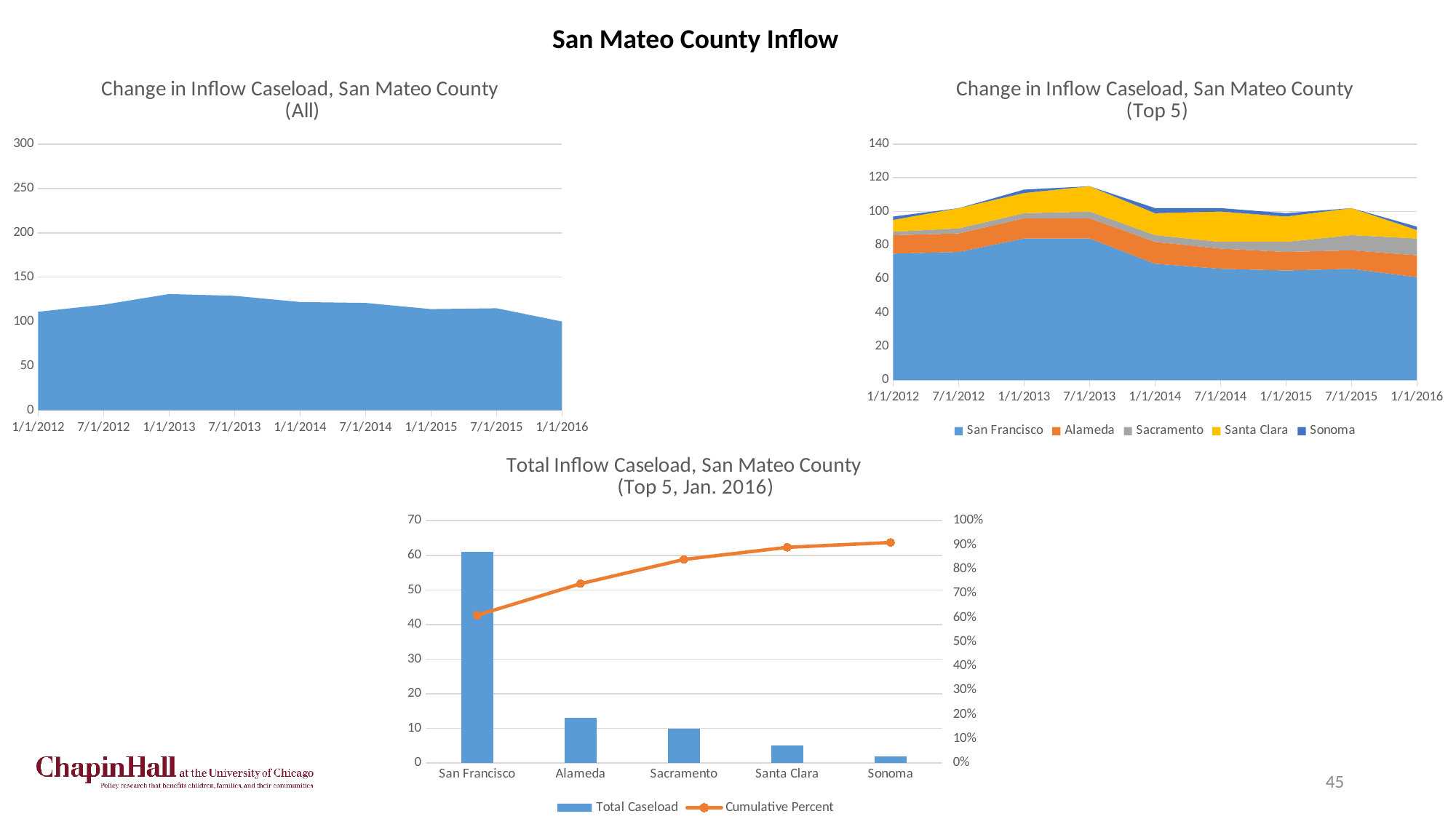
In 'Total Inflow Caseload, San Mateo County (Top 5, Jan. 2016)', which county has the highest total caseload bar? San Francisco In 'Total Inflow Caseload, San Mateo County (Top 5, Jan. 2016)', which has the larger total caseload bar, Alameda or Sacramento? Alameda How many series does the legend of 'Change in Inflow Caseload, San Mateo County (Top 5)' list? 5 In 'Total Inflow Caseload, San Mateo County (Top 5, Jan. 2016)', is the total caseload bar for San Francisco greater or less than 50? greater What are the two legend entries of 'Total Inflow Caseload, San Mateo County (Top 5, Jan. 2016)'? Total Caseload, Cumulative Percent What kind of chart is 'Change in Inflow Caseload, San Mateo County (All)'? Area chart In 'Change in Inflow Caseload, San Mateo County (All)', do the values rise or fall from 1/1/2013 to 1/1/2016? fall How many counties are shown on the x axis of 'Total Inflow Caseload, San Mateo County (Top 5, Jan. 2016)'? 5 In 'Change in Inflow Caseload, San Mateo County (Top 5)', is the top of the stacked area at 7/1/2013 greater or less than 100? greater In 'Total Inflow Caseload, San Mateo County (Top 5, Jan. 2016)', which county has the lowest total caseload bar? Sonoma In 'Total Inflow Caseload, San Mateo County (Top 5, Jan. 2016)', is the total caseload bar for Alameda greater or less than 20? less